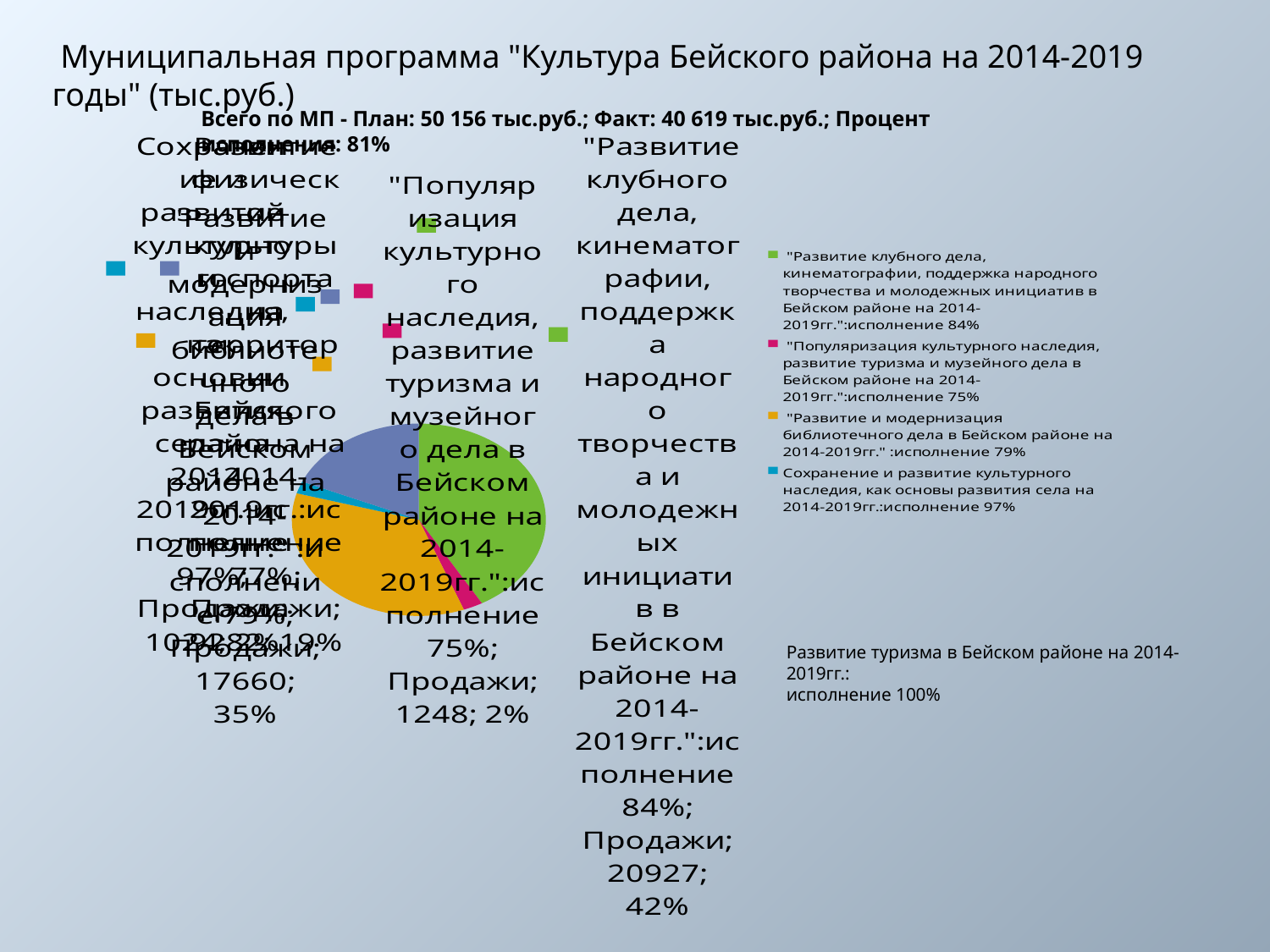
Which slice of the pie is the largest? Развитие клубного дела, кинематографии, поддержка народного творчества и молодежных инициатив What value is labelled on the slice for "Развитие и модернизация библиотечного дела"? 17660 What colour is the slice for "Развитие клубного дела, кинематографии, поддержка народного творчества и молодежных инициатив"? Green What value is labelled on the slice for "Развитие клубного дела, кинематографии, поддержка народного творчества и молодежных инициатив"? 20927 What share of the pie does the slice for "Популяризация культурного наследия, развитие туризма и музейного дела" take? 2% What is the difference between the values for "Развитие клубного дела" (20927) and "Развитие и модернизация библиотечного дела" (17660)? 3267 How many entries does the chart legend list? 4 Which is larger: the slice for "Развитие клубного дела" or the slice for "Развитие и модернизация библиотечного дела"? Развитие клубного дела According to the text above the chart, what is the overall percent of execution (Процент выполнения) for the programme? 81% What value is labelled on the slice for "Популяризация культурного наследия, развитие туризма и музейного дела"? 1248 What share of the pie does the slice for "Развитие клубного дела, кинематографии, поддержка народного творчества и молодежных инициатив" take? 42% What kind of chart is shown on the slide? Pie chart